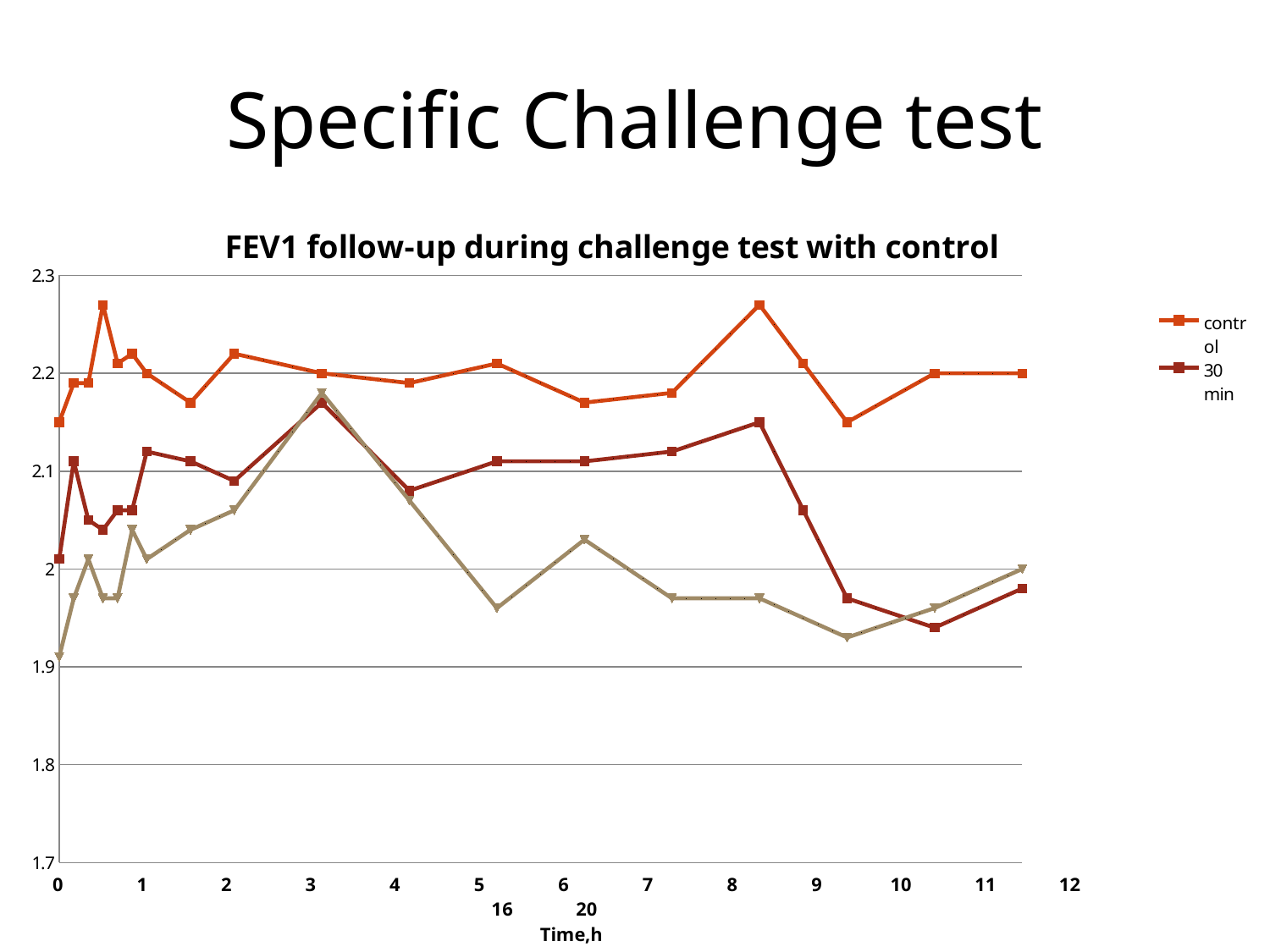
Is the value of the 30 min series at about 10.4 h greater or less than 2? less What kind of chart is shown on the slide? line chart Is the value of the control series at about 8.3 h greater or less than 2.2? greater Is the value of the 30 min series at about 3.1 h greater or less than 2.1? greater Does the control series rise or fall between about 7.3 h and 8.3 h? rise What is the title of the chart? FEV1 follow-up during challenge test with control At time 0, which series has the larger value, control or 30 min? control What is the label of the x axis? Time,h Does the 30 min series rise or fall between about 8.3 h and 9.4 h? fall Which series stays highest across the whole time range? control How many series does the legend list? 2